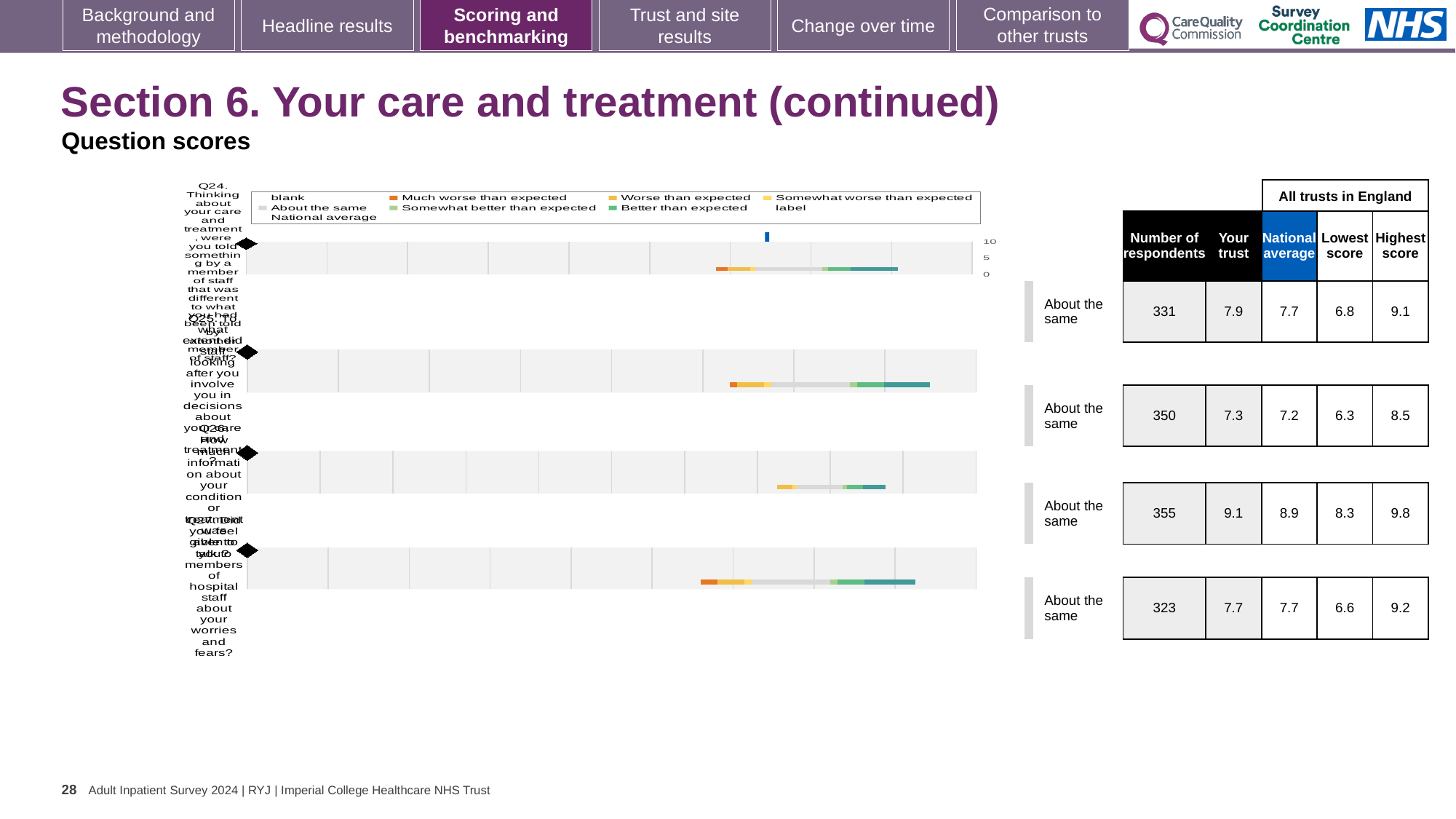
How many question charts (Q24 to Q27) are shown on the slide? 4 For the Q24 chart, which is larger: the 'Your trust' score or the national average? Your trust For the Q26 chart, what is the difference between the highest score and the lowest score? 1.5 Which of the four questions (Q24 to Q27) has the highest 'Your trust' score? Q26 On the Q24 chart, is the national average marker greater or less than 5 on the axis? greater For the Q27 chart, what is the highest score among all trusts in England? 9.2 What benchmark category label is shown next to the Q25 chart? About the same What kind of chart is used to show the Q24 benchmarking result? bar chart For the Q25 chart, what is the number of respondents? 350 For the Q26 chart, what is the national average score? 8.9 In the chart legend, which category is shown in orange? Much worse than expected For the Q24 chart, what is the 'Your trust' score in the table? 7.9